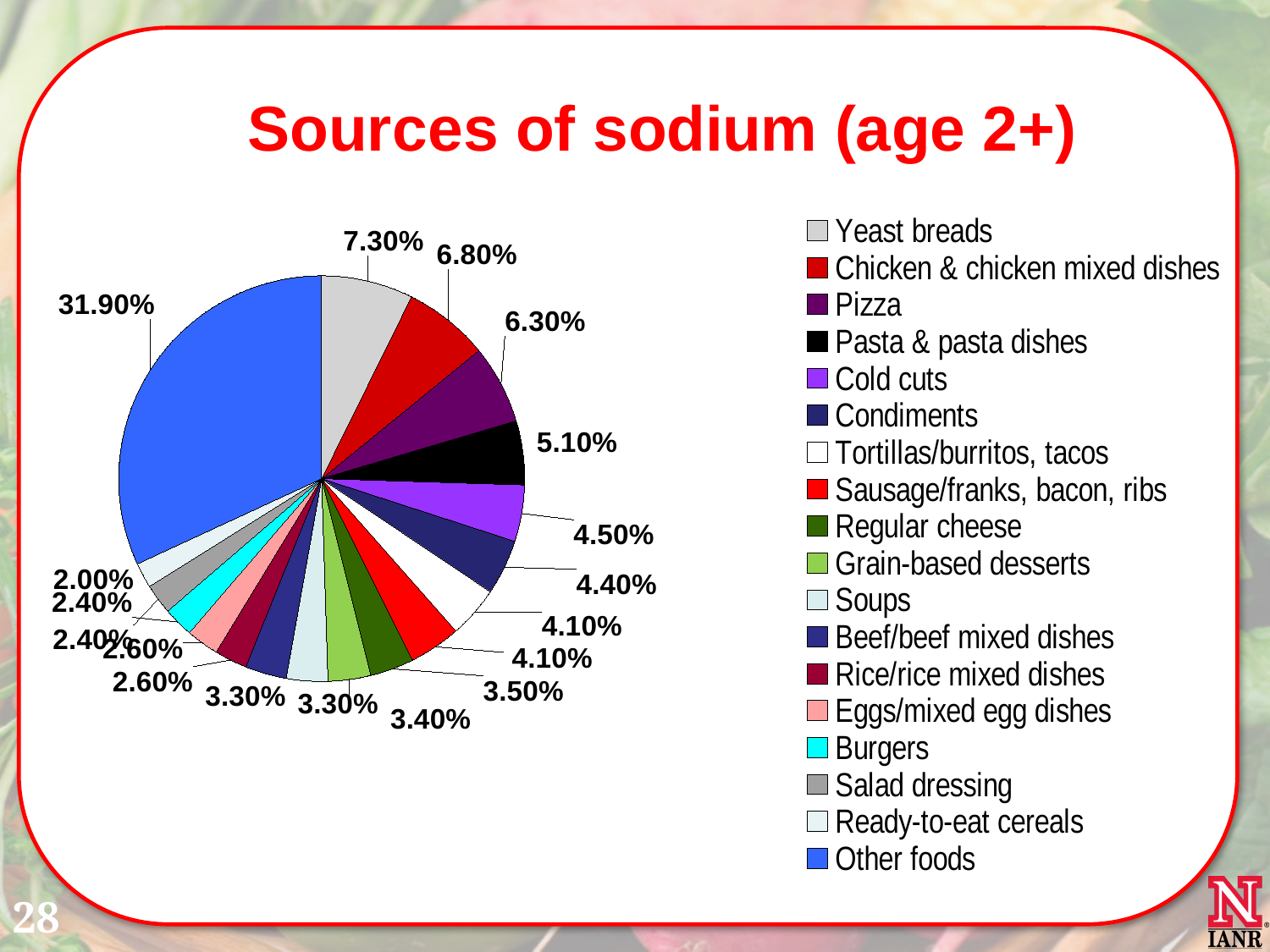
What is the value for Pizza? 6.30% What is the title of the chart? Sources of sodium (age 2+) Which is larger, the share for Yeast breads or the share for Pizza? Yeast breads Which category has the largest share of the pie? Other foods What share of the pie is Yeast breads? 7.30% What is the value for Pasta & pasta dishes? 5.10% What is the difference between the share for Other foods and the share for Yeast breads? 24.60% What is the value for Chicken & chicken mixed dishes? 6.80% What share of the pie is Other foods? 31.90% Which category has the smallest share of the pie? Ready-to-eat cereals What type of chart is shown on the slide? Pie chart How many categories does the legend list? 18